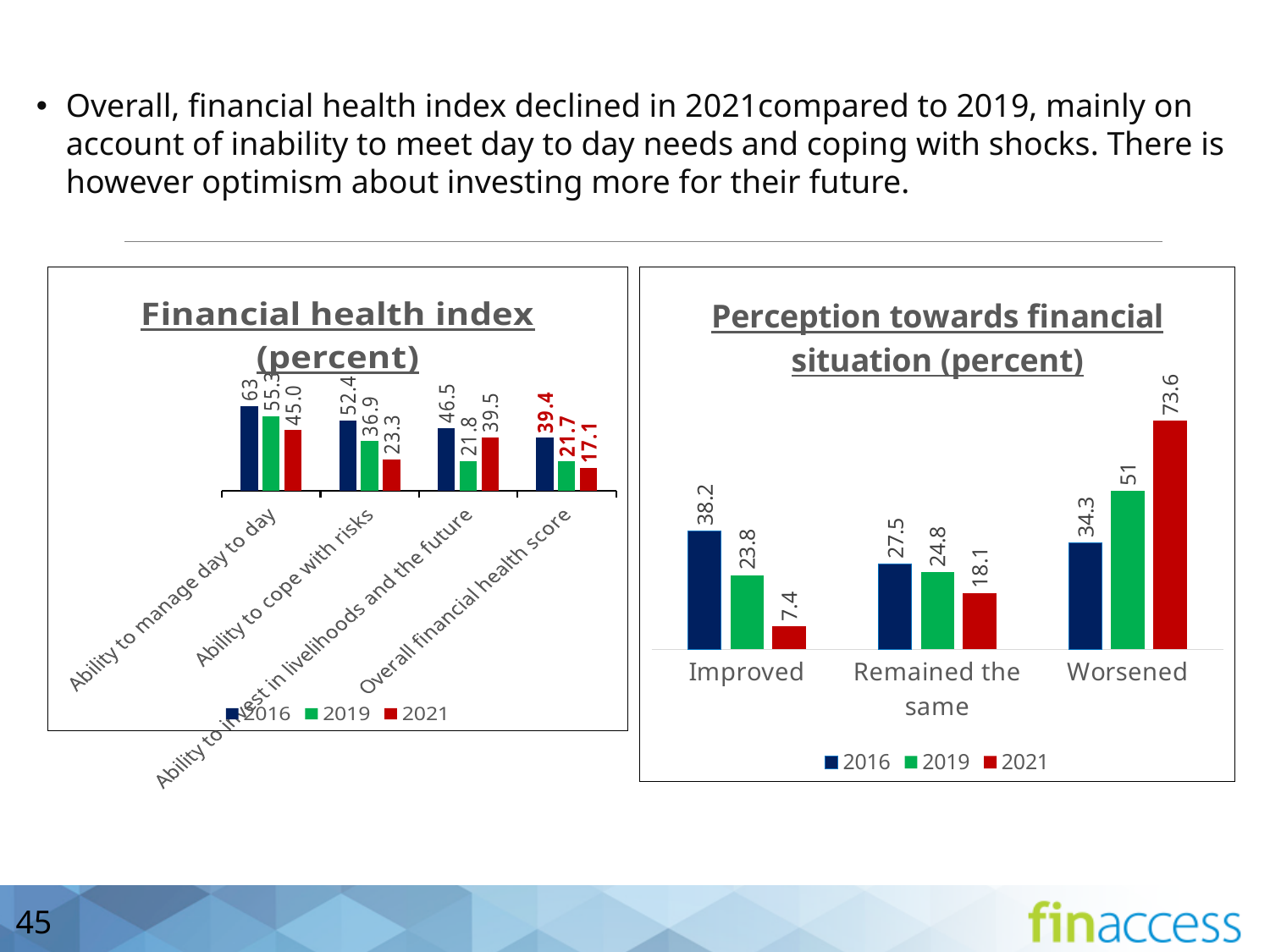
In the 'Perception towards financial situation (percent)' chart, what is the value for Worsened in 2021? 73.6 In the 'Financial health index (percent)' chart, which is larger for Ability to invest in livelihoods and the future: the 2019 value or the 2021 value? 2021 In the 'Perception towards financial situation (percent)' chart, which category has the lowest 2021 value? Improved In the 'Financial health index (percent)' chart, what is the Overall financial health score for 2021? 17.1 How many categories are shown in the 'Financial health index (percent)' chart? 4 How many series does the legend of the 'Perception towards financial situation (percent)' chart list? 3 In the 'Financial health index (percent)' chart, what is the value for Ability to cope with risks in 2019? 36.9 In the 'Perception towards financial situation (percent)' chart, what is the value for Improved in 2016? 38.2 In the 'Perception towards financial situation (percent)' chart, what is the difference between the 2021 and 2016 values for Worsened? 39.3 What kind of chart is the 'Perception towards financial situation (percent)' chart? Bar chart In the 'Financial health index (percent)' chart, what is the difference between the 2016 and 2019 Overall financial health score? 17.7 In the 'Perception towards financial situation (percent)' chart, which category has the highest 2019 value? Worsened